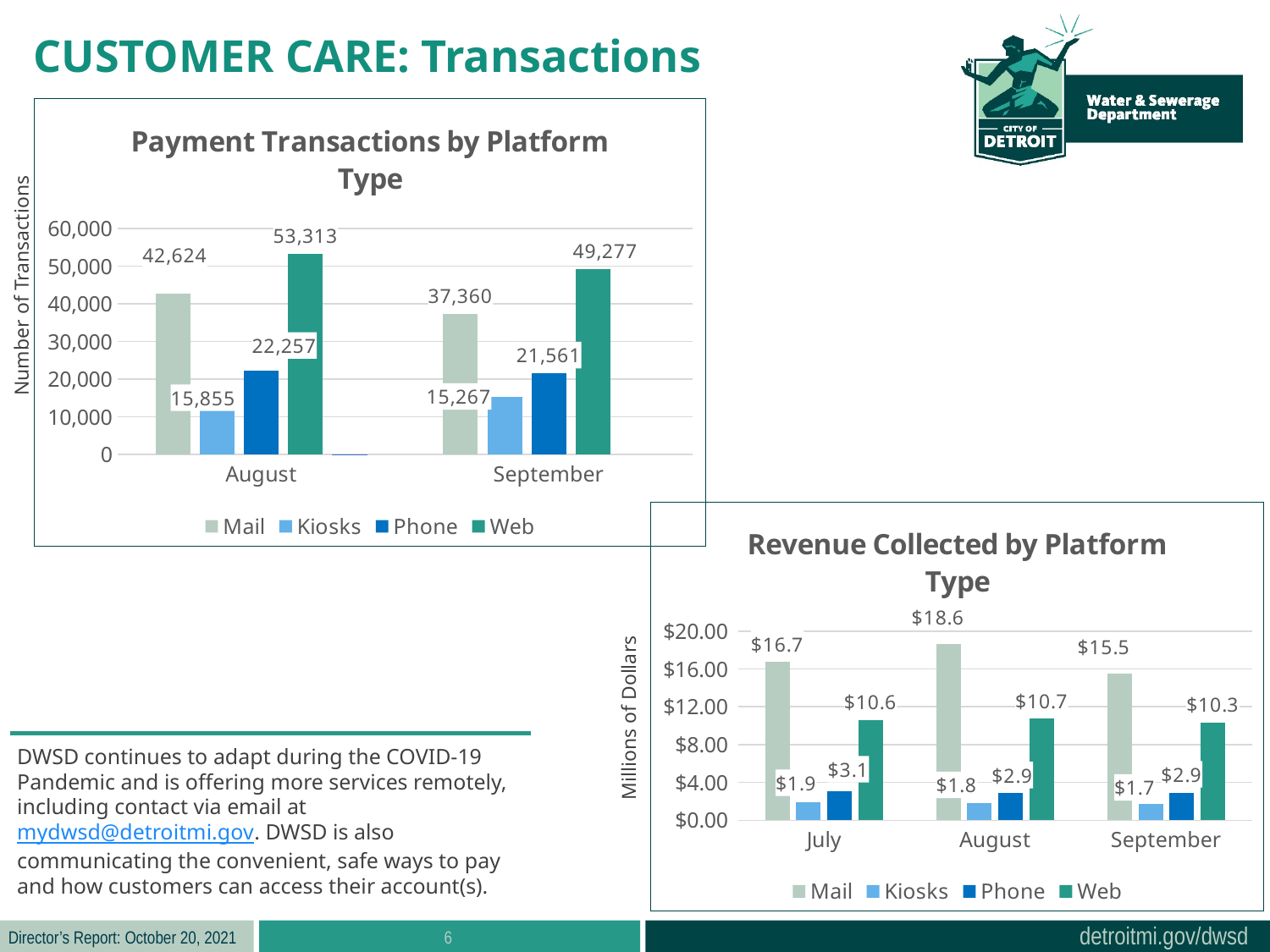
In the 'Payment Transactions by Platform Type' chart, how many Web transactions were there in August? 53,313 What type of chart is 'Revenue Collected by Platform Type'? bar chart In the 'Payment Transactions by Platform Type' chart, which platform had the most transactions in September? Web In the 'Payment Transactions by Platform Type' chart, how many series does the legend list? 4 In the 'Revenue Collected by Platform Type' chart, which month had the highest Mail revenue? August In the 'Revenue Collected by Platform Type' chart, how many months are shown on the x axis? 3 In the 'Payment Transactions by Platform Type' chart, which platform had the fewest transactions in August? Kiosks In the 'Revenue Collected by Platform Type' chart, how much revenue was collected by Mail in August? $18.6 In the 'Revenue Collected by Platform Type' chart, is Phone revenue in July larger or smaller than Phone revenue in August? larger In the 'Payment Transactions by Platform Type' chart, how many Kiosks transactions were there in September? 15,267 In the 'Payment Transactions by Platform Type' chart, what is the difference between Mail transactions in August and September? 5,264 In the 'Revenue Collected by Platform Type' chart, how much revenue was collected by Web in September? $10.3